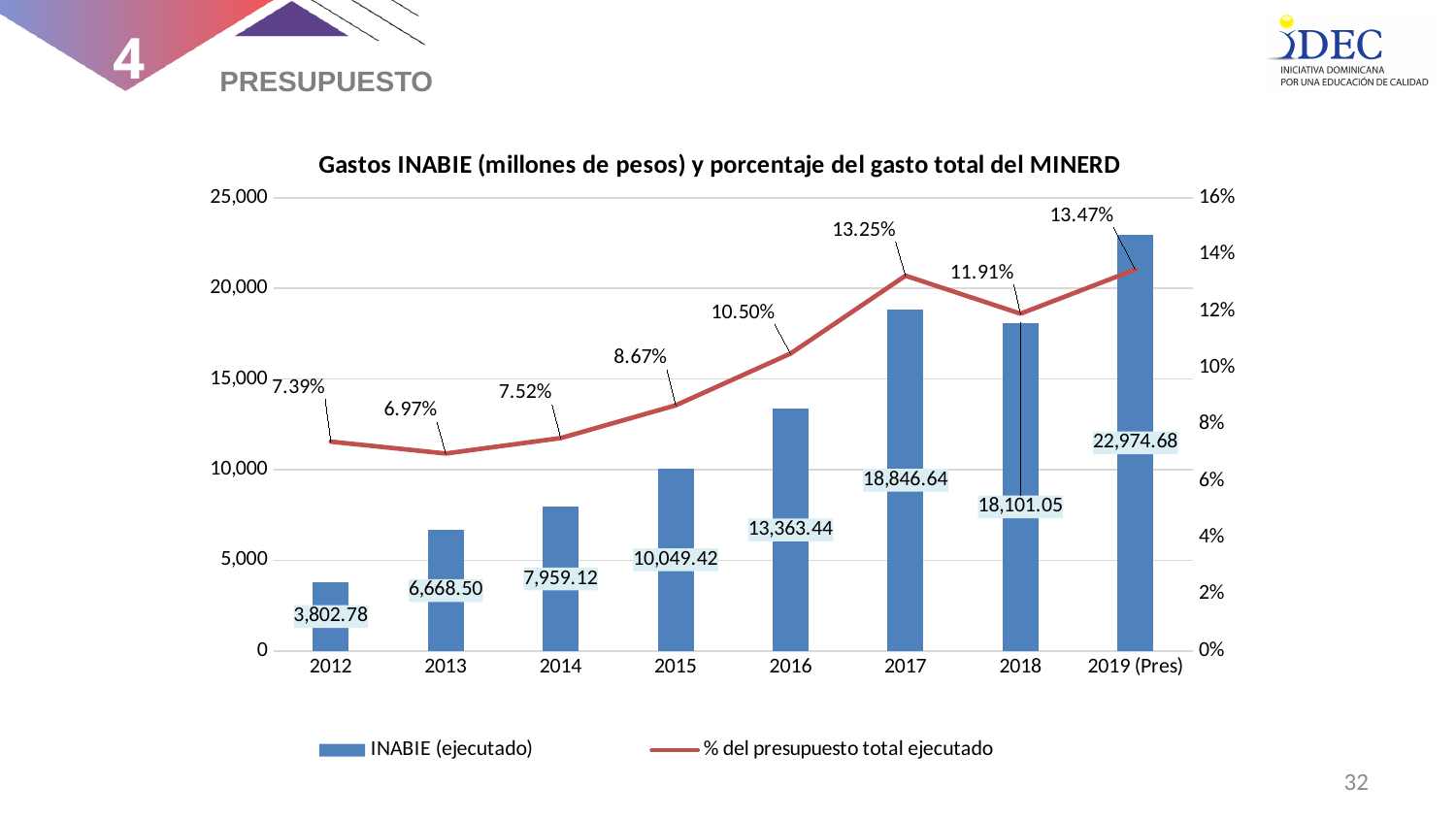
What is the INABIE (ejecutado) value for 2012? 3,802.78 Is the INABIE (ejecutado) value for 2014 greater or less than 10,000? less What is the % del presupuesto total ejecutado for 2013? 6.97% Which is larger, the INABIE (ejecutado) value for 2015 or for 2016? 2016 Which year has the highest INABIE (ejecutado) value? 2019 (Pres) What is the title of the chart? Gastos INABIE (millones de pesos) y porcentaje del gasto total del MINERD What is the INABIE (ejecutado) value for 2017? 18,846.64 What is the % del presupuesto total ejecutado for 2016? 10.50% How many years are shown on the x axis? 8 What is the difference between the INABIE (ejecutado) values for 2017 and 2018? 745.59 How many series does the legend list? 2 Which year has the lowest % del presupuesto total ejecutado? 2013